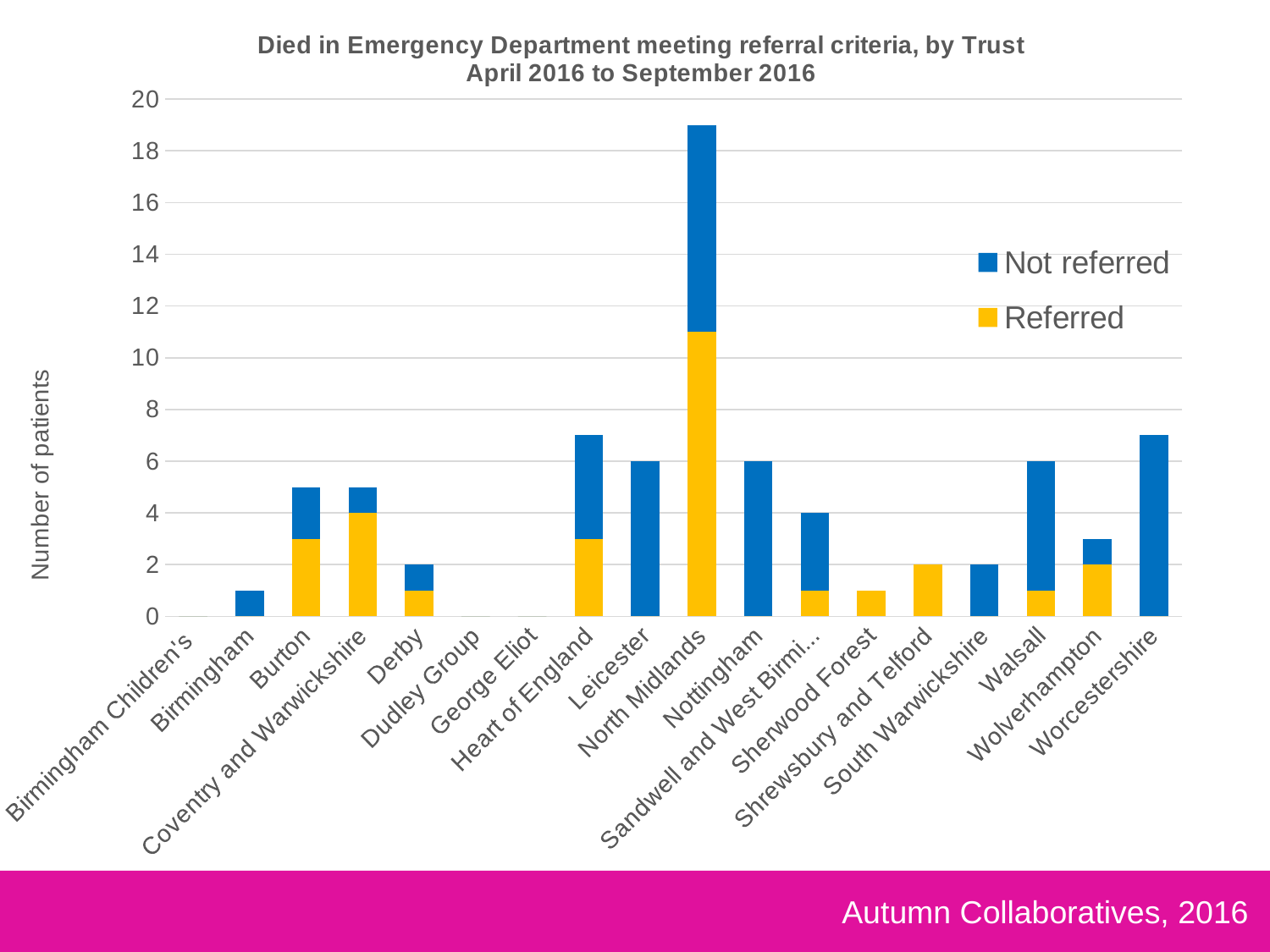
What is the total number of patients for Sandwell and West Birmingham? 4 How many trusts are shown along the x axis? 18 What is the Referred value for Coventry and Warwickshire? 4 What is the total number of patients for Leicester? 6 What kind of chart is shown on the slide? Stacked bar chart What is the Referred value for Shrewsbury and Telford? 2 Is the Referred value for North Midlands greater or less than 10? greater Which has a larger total, Worcestershire or Wolverhampton? Worcestershire Which trust has the highest total number of patients? North Midlands Is the total for North Midlands greater or less than 18? greater What is the label of the y axis? Number of patients How many series does the legend list? 2